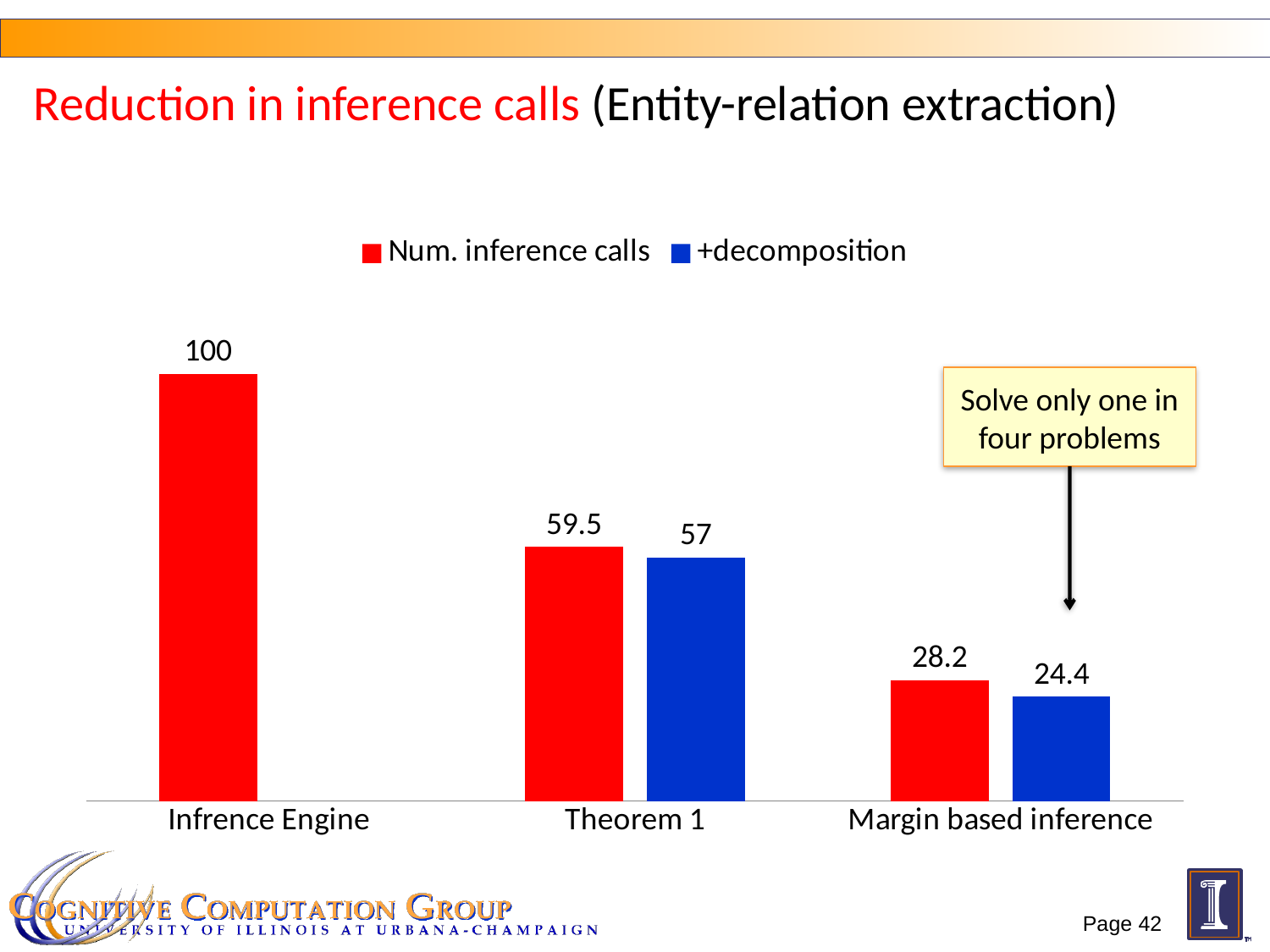
How many series does the legend list? 2 What is the difference between Num. inference calls and +decomposition for Margin based inference? 3.8 Which is larger: Num. inference calls for Theorem 1 or +decomposition for Theorem 1? Num. inference calls for Theorem 1 What is the value of Num. inference calls for Infrence Engine? 100 What is the value of +decomposition for Theorem 1? 57 What is the value of +decomposition for Margin based inference? 24.4 Which category has the lowest value for Num. inference calls? Margin based inference What is the value of Num. inference calls for Theorem 1? 59.5 What is the difference between Num. inference calls for Theorem 1 and for Margin based inference? 31.3 Which category has the highest value for Num. inference calls? Infrence Engine What kind of chart is shown on the slide? Bar chart What is the value of Num. inference calls for Margin based inference? 28.2